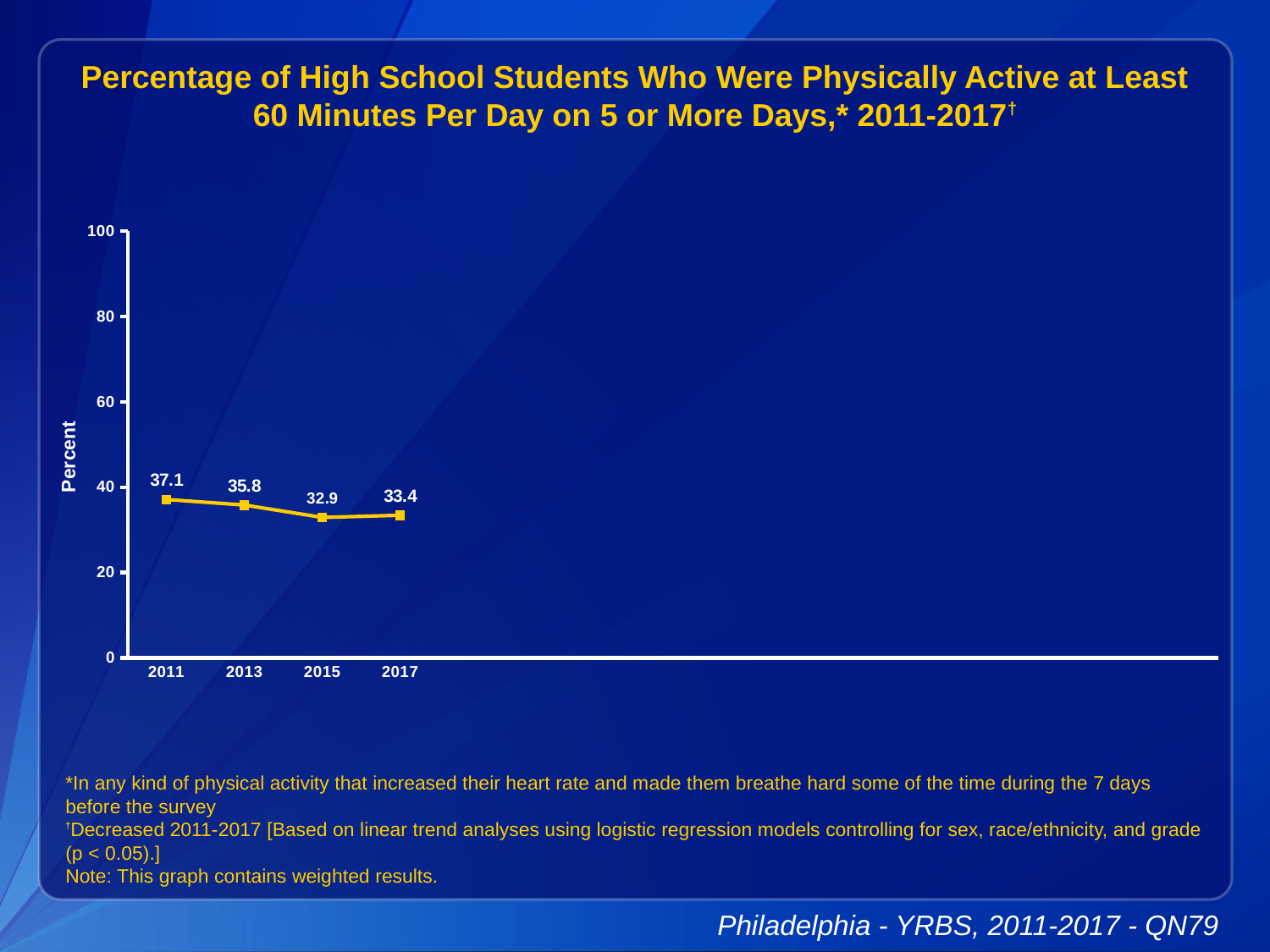
What is the value plotted for 2017? 33.4 Which is larger, the value for 2013 or the value for 2017? 2013 Is the value for 2013 greater or less than 40? less What is the label on the vertical axis? Percent What kind of chart is shown on the slide? line chart What percentage of high school students were physically active at least 60 minutes per day on 5 or more days in 2011? 37.1 Which year has the highest percentage? 2011 What is the difference between the 2011 value and the 2017 value? 3.7 How many years are plotted on the chart? 4 Which year has the lowest percentage? 2015 What is the value plotted for 2015? 32.9 Do the values generally rise or fall from 2011 to 2017? fall